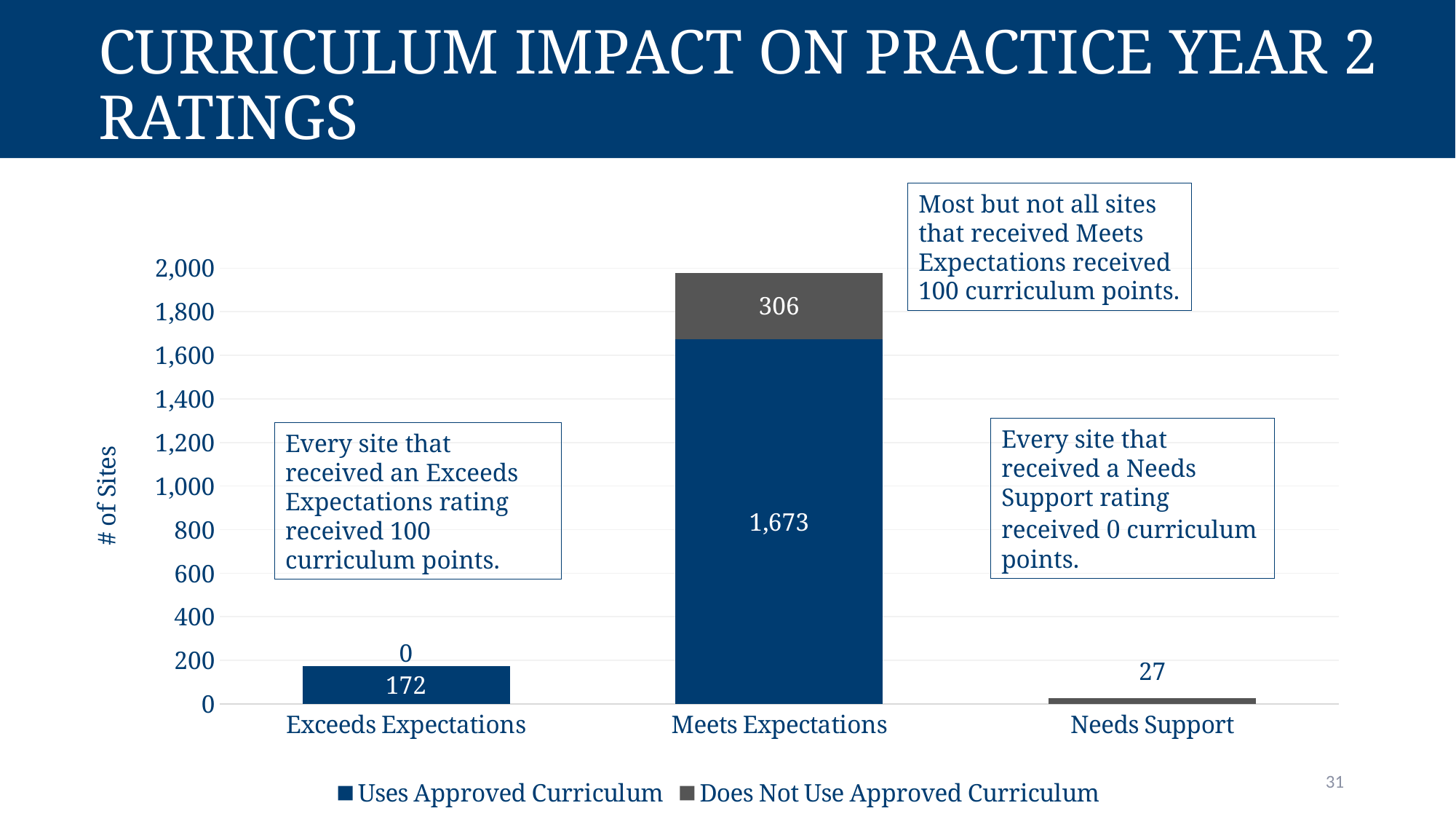
What is the value for Uses Approved Curriculum in the Exceeds Expectations category? 172 What is the value for Does Not Use Approved Curriculum in the Needs Support category? 27 What is the label on the y axis? # of Sites How many series does the legend list? 2 What is the value for Uses Approved Curriculum in the Meets Expectations category? 1,673 What is the difference between the Uses Approved Curriculum values for Meets Expectations and Exceeds Expectations? 1,501 What type of chart is shown on the slide? Stacked bar chart What is the total number of sites in the Meets Expectations bar? 1,979 How many rating categories are shown on the x axis? 3 What is the value for Does Not Use Approved Curriculum in the Exceeds Expectations category? 0 What is the value for Does Not Use Approved Curriculum in the Meets Expectations category? 306 Which category has the highest total number of sites? Meets Expectations